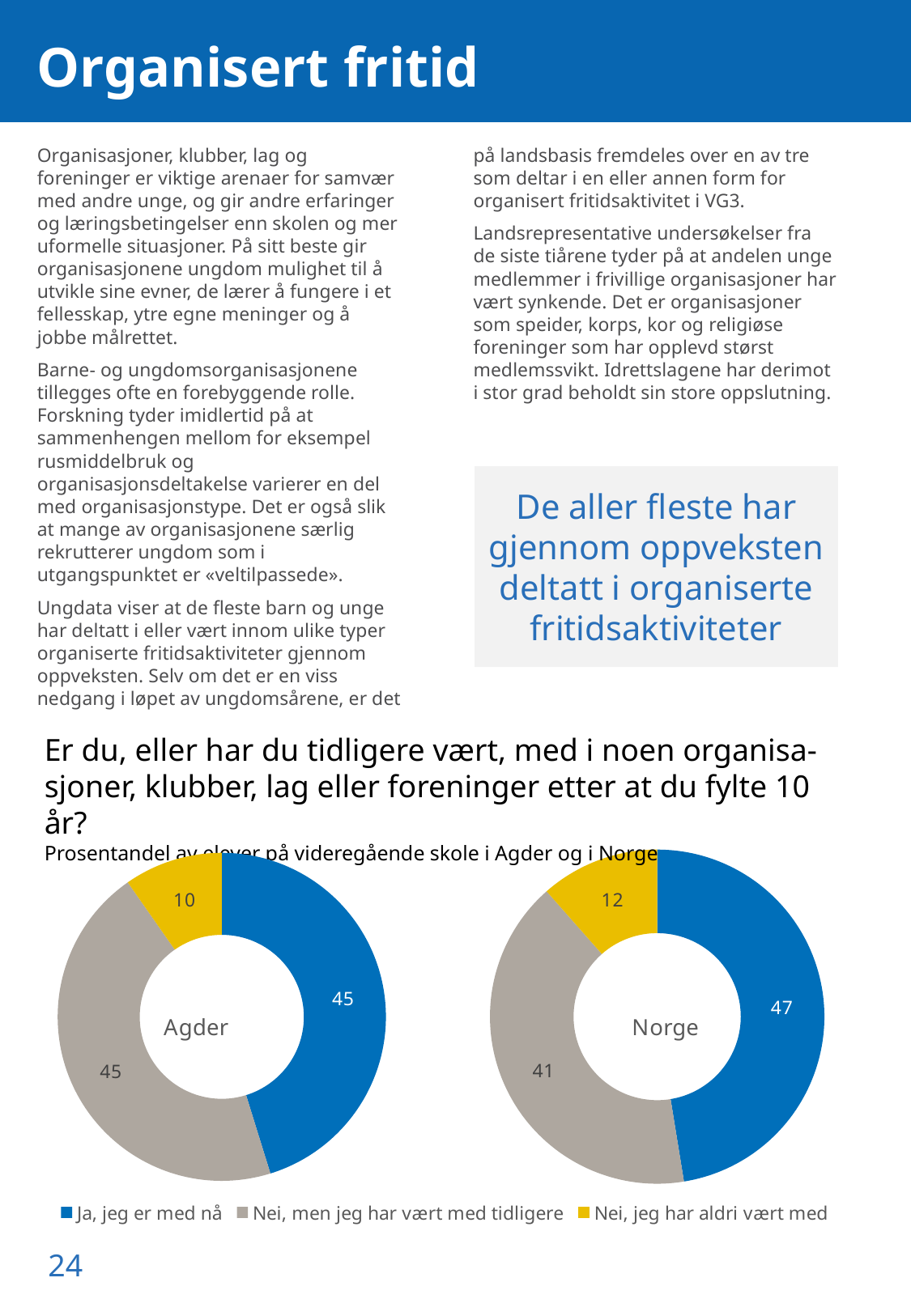
In the Agder chart, which category has the smallest share? Nei, jeg har aldri vært med Which is larger: "Nei, jeg har aldri vært med" in the Agder chart or in the Norge chart? Norge What kind of chart is used for Agder and Norge? Donut (pie) chart What is the difference between the "Ja, jeg er med nå" value in the Norge chart and the same value in the Agder chart? 2 In the Norge chart, what is the difference between "Ja, jeg er med nå" and "Nei, men jeg har vært med tidligere"? 6 In the Norge chart, what is the value for "Nei, men jeg har vært med tidligere"? 41 In the Agder chart, what is the value for "Nei, jeg har aldri vært med"? 10 In the Agder chart, what is the value for "Ja, jeg er med nå"? 45 How many categories does the legend list for the charts? 3 Which colour represents "Nei, jeg har aldri vært med" in the charts? Yellow How many slices does the Agder chart have? 3 In the Norge chart, which category has the largest share? Ja, jeg er med nå